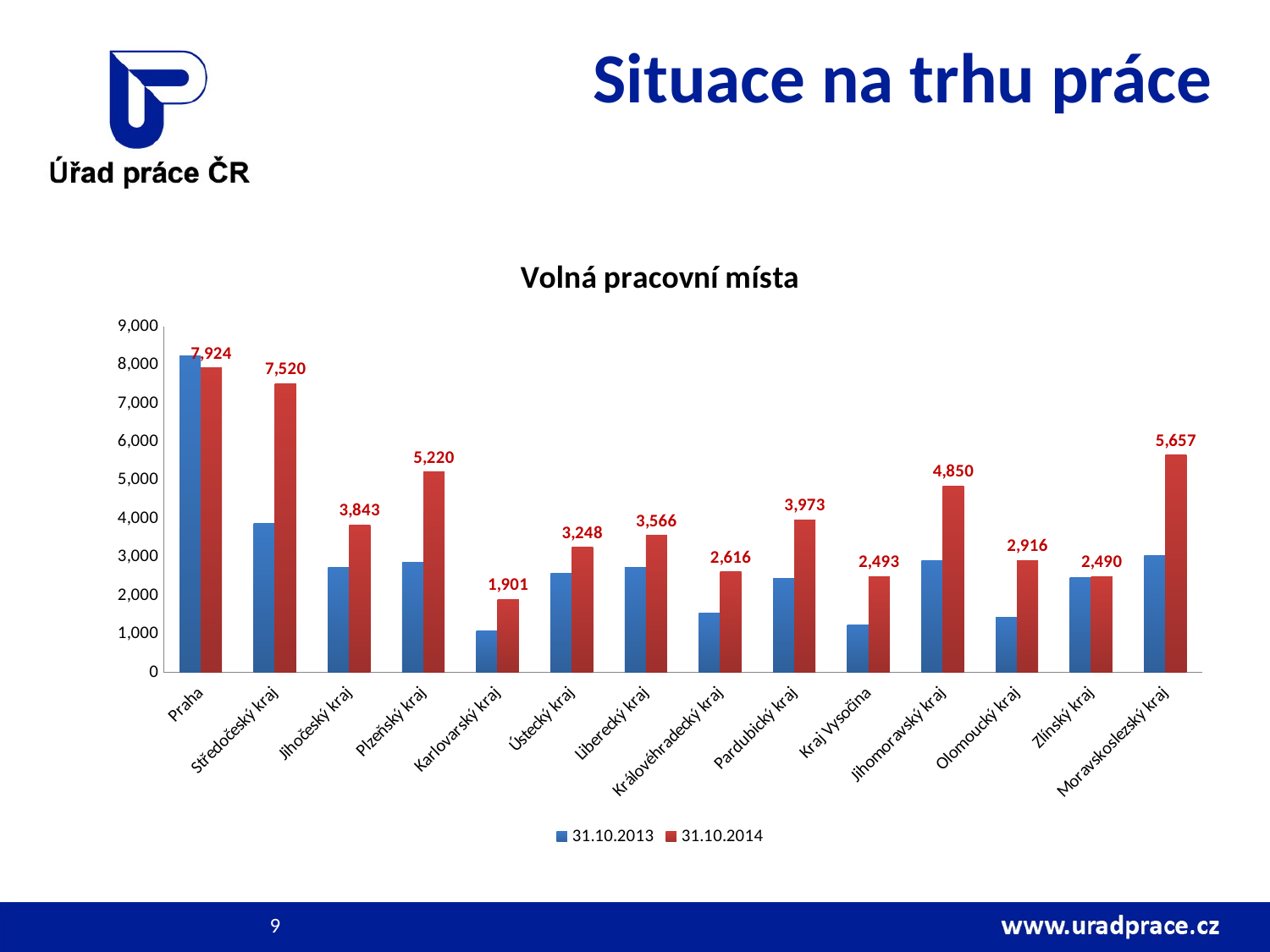
Is the 31.10.2013 value for Jihočeský kraj greater or less than 3,000? less What is the value for Praha in the 31.10.2014 series? 7,924 For Praha, which series has the larger value, 31.10.2013 or 31.10.2014? 31.10.2013 How many series does the legend list? 2 What is the difference between the 31.10.2014 values for Praha and Středočeský kraj? 404 How many regions are shown on the x axis of the chart? 14 Which region has the highest value in the 31.10.2014 series? Praha Is the 31.10.2013 value for Praha greater or less than 8,000? greater Which region has the lowest value in the 31.10.2014 series? Karlovarský kraj What is the value for Moravskoslezský kraj in the 31.10.2014 series? 5,657 Which is larger for Plzeňský kraj or Jihomoravský kraj in the 31.10.2014 series? Plzeňský kraj What is the value for Karlovarský kraj in the 31.10.2014 series? 1,901